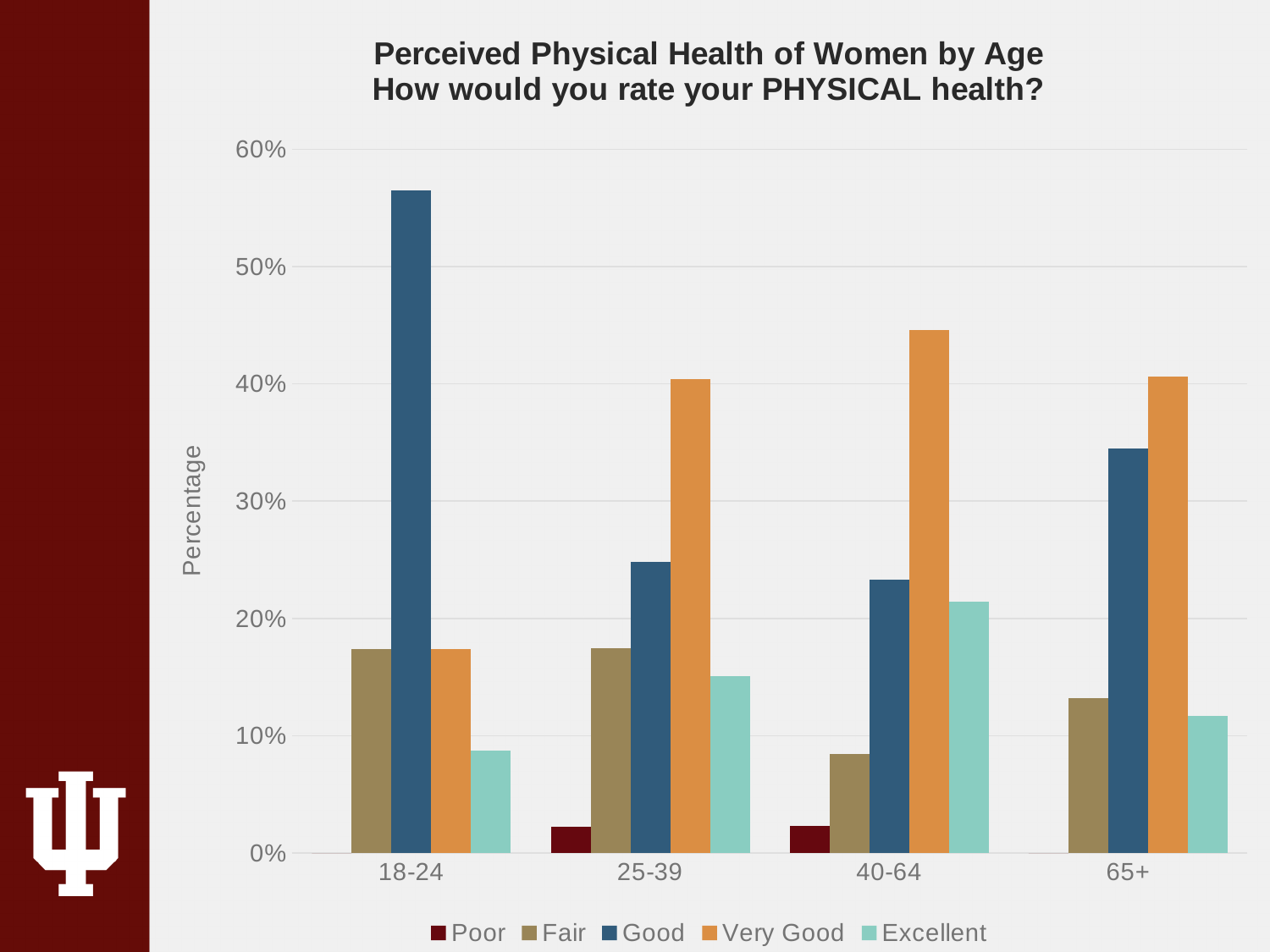
Is the value for Good in the 18-24 age group greater or less than 50%? greater Which age group has the highest value for Very Good? 40-64 Which age group has the larger value for Excellent: 18-24 or 40-64? 40-64 What is the label on the y axis? Percentage Which rating has the lowest value in the 40-64 age group? Poor How many series does the legend list? 5 How many age groups are shown on the x axis? 4 Is the value for Very Good in the 40-64 age group greater or less than 40%? greater For the 25-39 age group, which is larger: Good or Very Good? Very Good What kind of chart is shown on the slide? bar chart Is the value for Fair in the 65+ age group greater or less than 10%? greater Which age group has the highest value for Good? 18-24